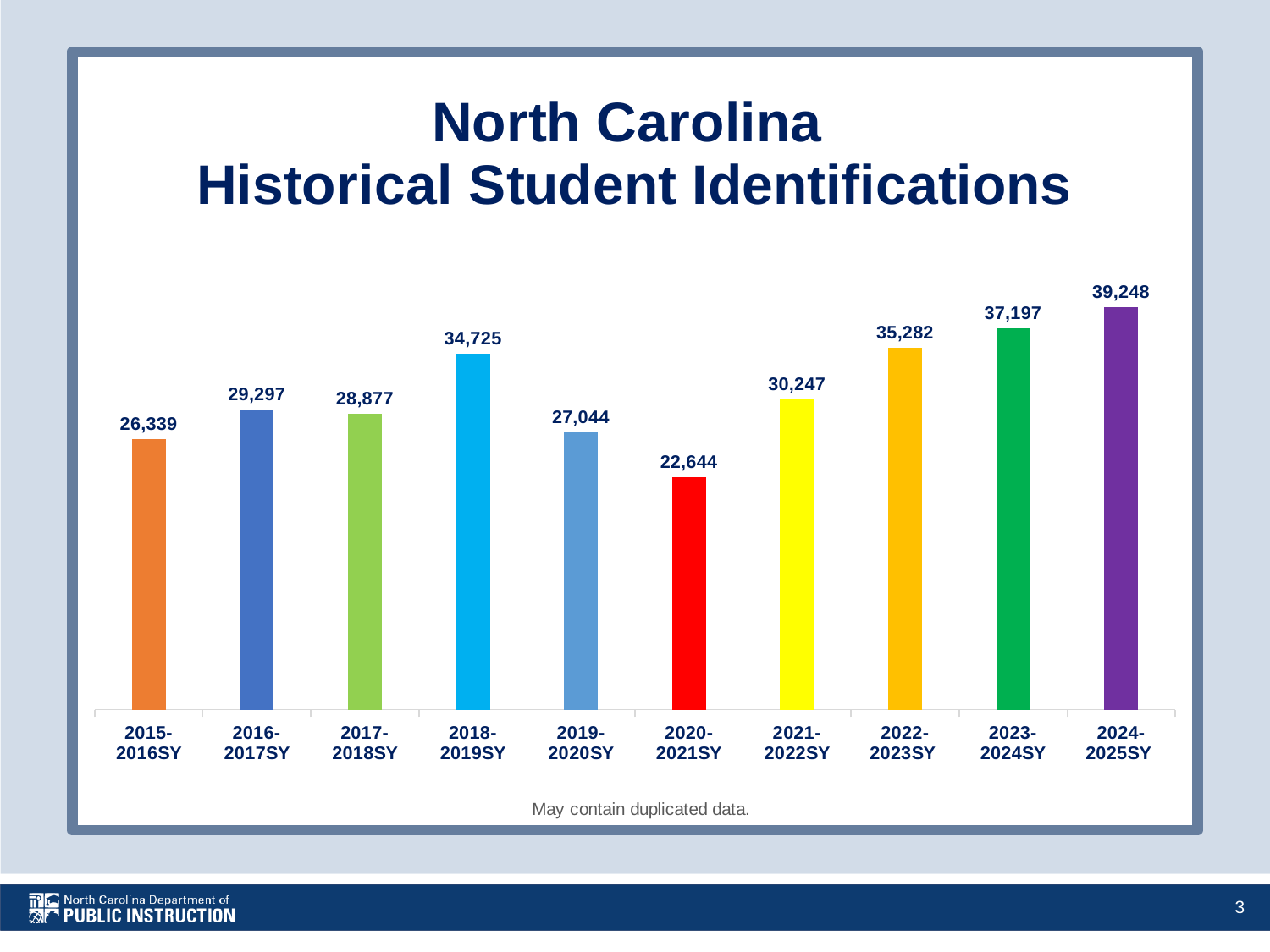
What is the title of the chart? North Carolina Historical Student Identifications What is the difference between the 2019-2020SY and 2020-2021SY values? 4,400 Which is larger, the value for 2016-2017SY or the value for 2017-2018SY? 2016-2017SY Which school year has the lowest number of student identifications? 2020-2021SY What is the number of student identifications for the 2020-2021SY? 22,644 What kind of chart is shown on the slide? Bar chart What is the number of student identifications for the 2022-2023SY? 35,282 Do the values rise or fall from 2020-2021SY to 2024-2025SY? Rise How many school years are shown on the chart? 10 What is the number of student identifications for the 2018-2019SY? 34,725 What is the difference between the 2024-2025SY and 2023-2024SY values? 2,051 Which school year has the highest number of student identifications? 2024-2025SY